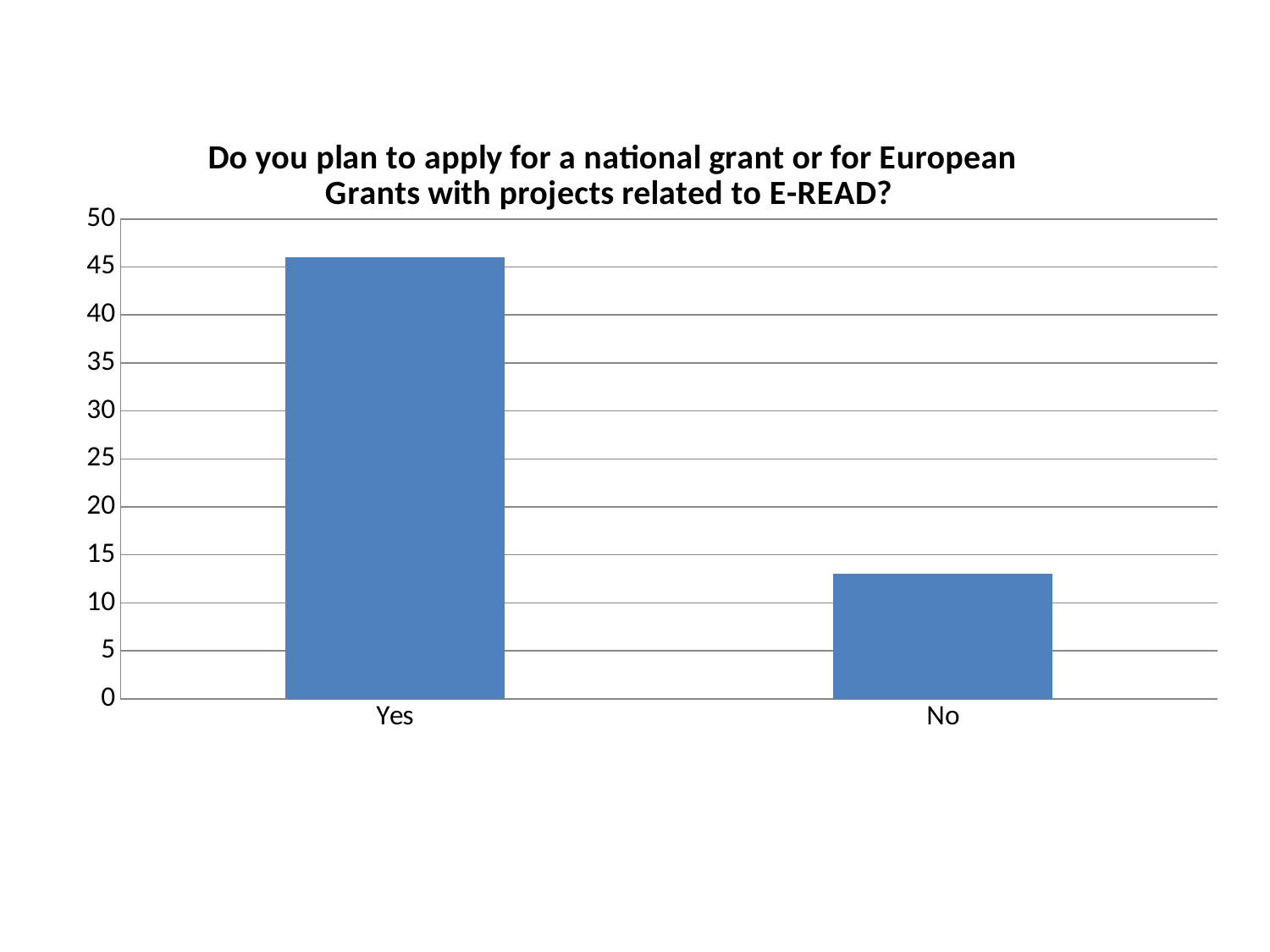
Which is larger, the value for Yes or the value for No? Yes Is the value for No greater or less than 10? greater Is the value for Yes greater or less than 50? less Which category has the highest bar? Yes Is the value for No greater or less than 15? less How many categories are shown on the x axis? 2 What is the maximum value shown on the y axis? 50 What kind of chart is shown on the slide? bar chart Which category has the lowest bar? No What is the title of the chart? Do you plan to apply for a national grant or for European Grants with projects related to E-READ?